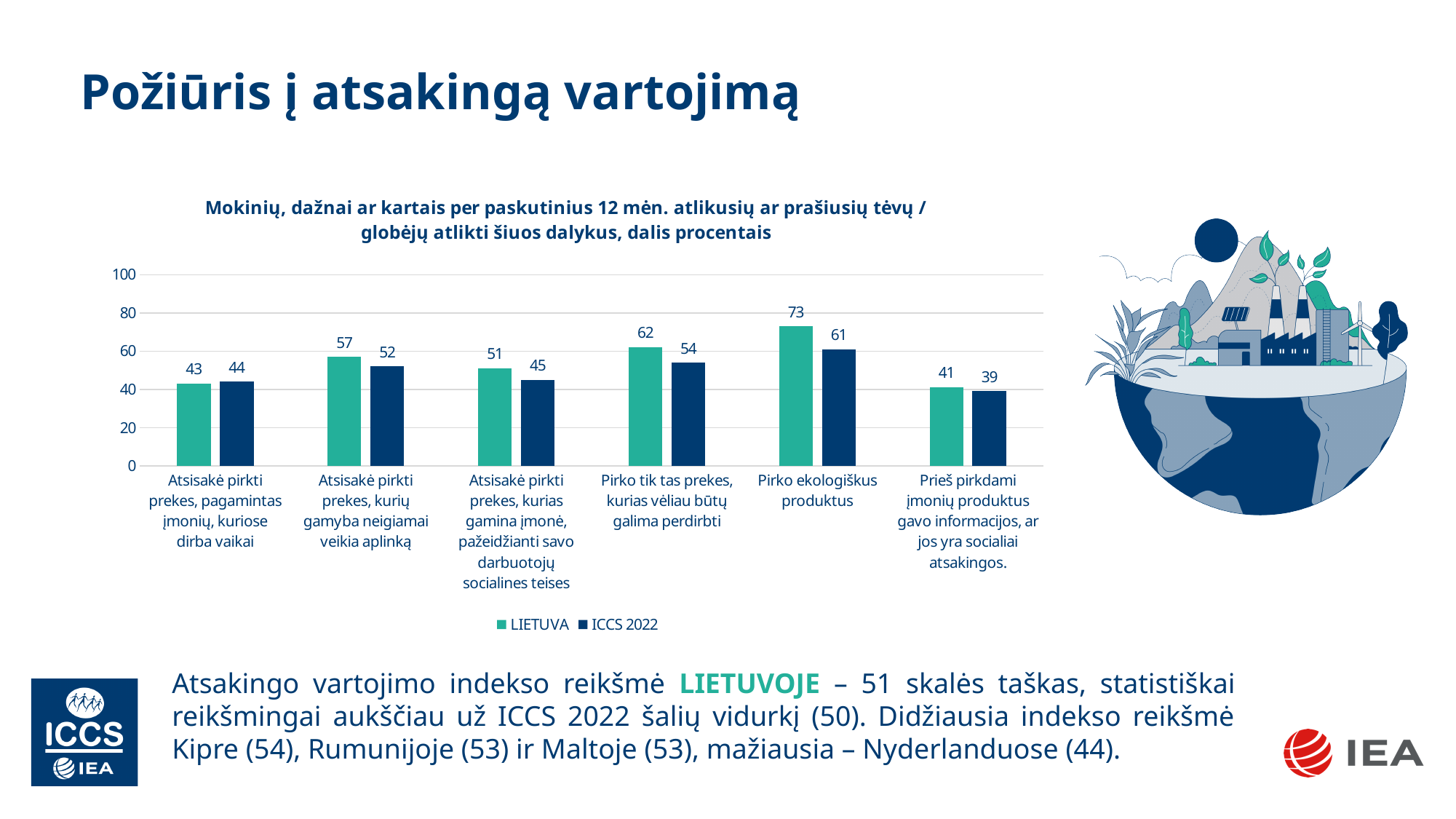
What kind of chart is shown on the slide? Bar chart For 'Atsisakė pirkti prekes, pagamintas įmonių, kuriose dirba vaikai', which series has the larger value, LIETUVA or ICCS 2022? ICCS 2022 What is the LIETUVA value for 'Atsisakė pirkti prekes, kurių gamyba neigiamai veikia aplinką'? 57 How many series does the chart legend list? 2 Which category has the highest LIETUVA value? Pirko ekologiškus produktus Which category has the lowest ICCS 2022 value? Prieš pirkdami įmonių produktus gavo informacijos, ar jos yra socialiai atsakingos. What is the ICCS 2022 value for 'Pirko tik tas prekes, kurias vėliau būtų galima perdirbti'? 54 What is the difference between the LIETUVA and ICCS 2022 values for 'Pirko tik tas prekes, kurias vėliau būtų galima perdirbti'? 8 What is the difference between the LIETUVA and ICCS 2022 values for 'Pirko ekologiškus produktus'? 12 How many categories are shown on the x axis of the chart? 6 Which series is shown in green in the chart? LIETUVA What is the LIETUVA value for 'Pirko ekologiškus produktus'? 73